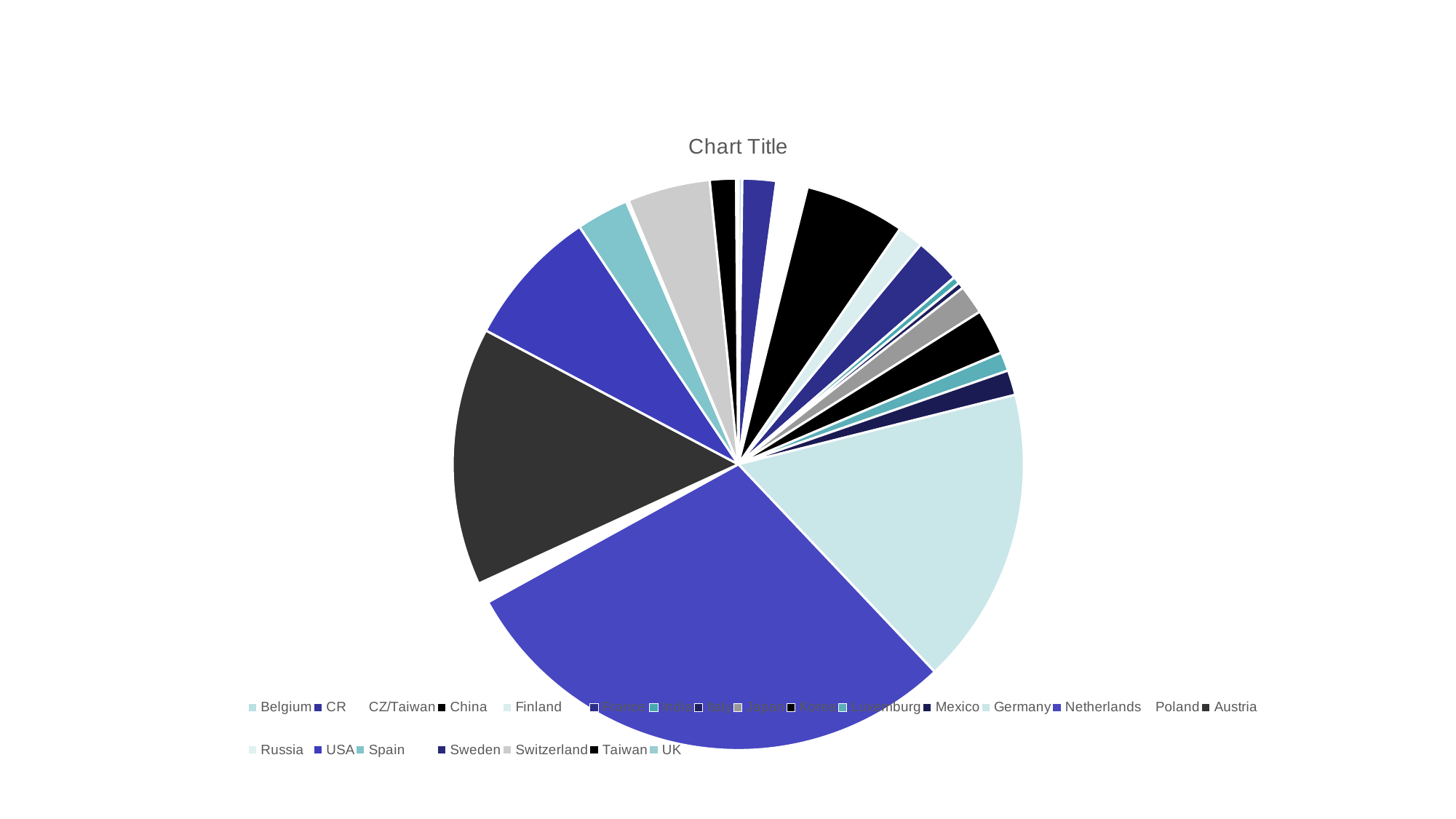
What is the title of the chart? Chart Title How many categories does the legend of the pie chart list? 23 Which slice is larger, Austria or USA? Austria Does the pie chart display data labels with values on its slices? No Which slice is larger, Netherlands or Germany? Netherlands What kind of chart is shown on the slide? pie chart Which slice is larger, USA or China? USA Which category has the largest slice of the pie? Netherlands